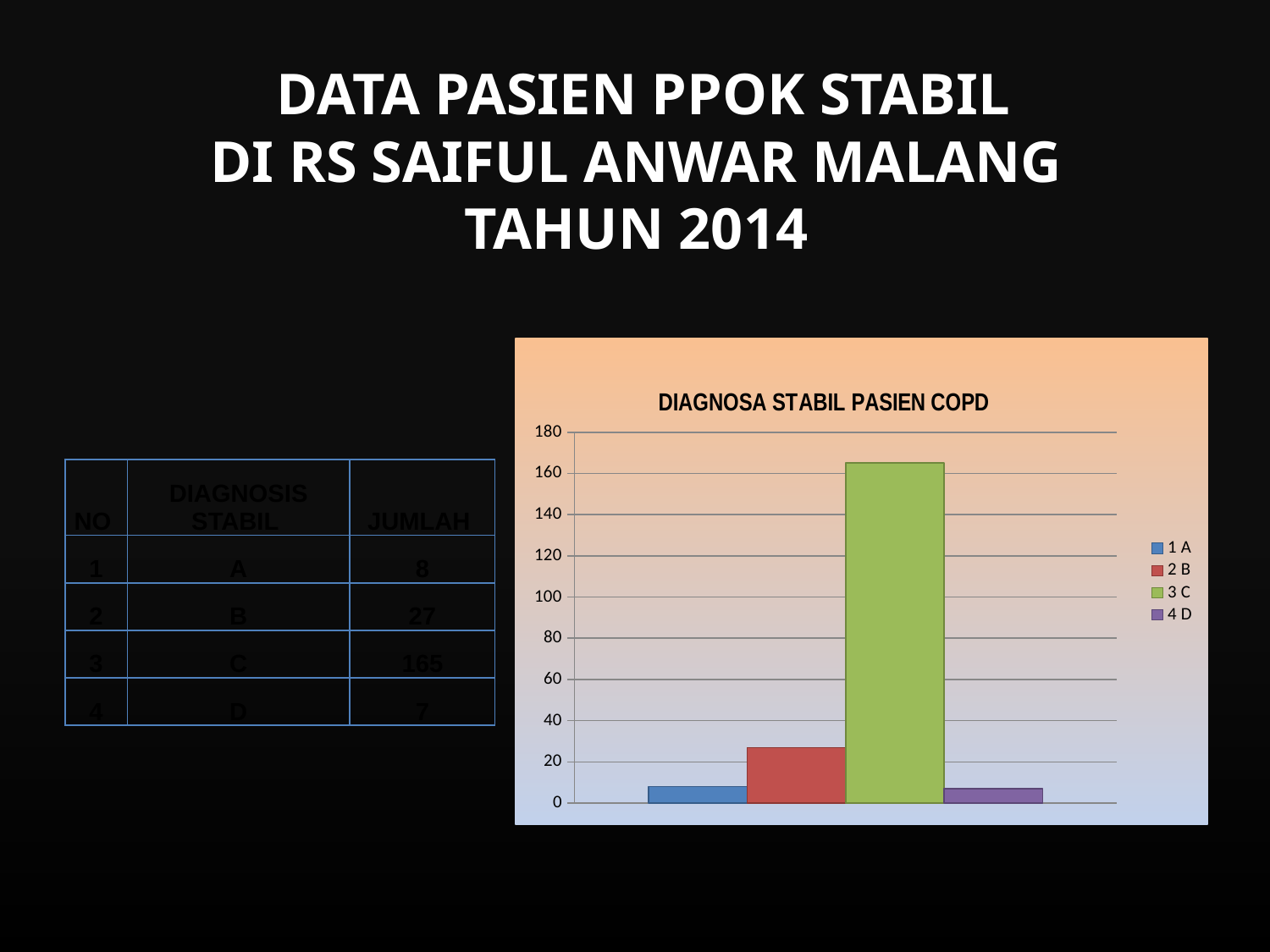
Is the value for 2 B greater or less than 40? less What is the title of the chart? DIAGNOSA STABIL PASIEN COPD Is the value for 2 B greater or less than 20? greater Which is larger, the value for 2 B or the value for 1 A? 2 B What colour is the bar for series 3 C? green Is the value for 3 C greater or less than 160? greater How many bars are plotted in the chart? 4 How many series does the chart legend list? 4 Which series has the highest bar in the chart? 3 C What kind of chart is shown on the slide? bar chart